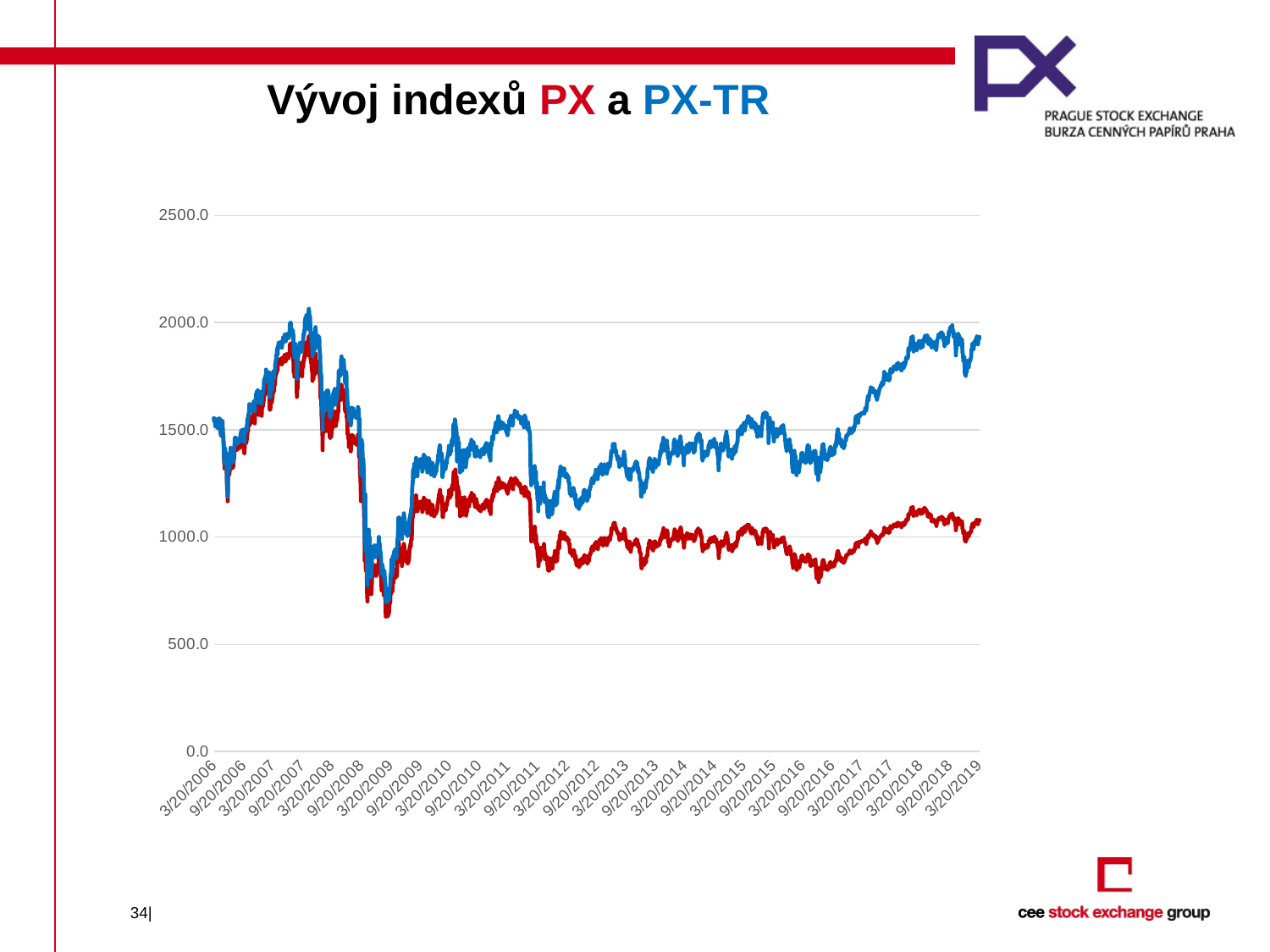
Is the value of PX at 9/20/2016 greater or less than 1000? less How many data series (lines) are plotted on the chart? 2 Is the value of PX-TR at 3/20/2019 greater or less than 1500? greater At 3/20/2019, which index has the higher value, PX or PX-TR? PX-TR What is the title of the slide containing the chart? Vývoj indexů PX a PX-TR Does the PX-TR line rise or fall between 3/20/2016 and 3/20/2018? rise What kind of chart is shown on the slide? line chart Does the PX line rise or fall between 9/20/2007 and 3/20/2009? fall Is the value of PX at 3/20/2006 greater or less than 1000? greater Which colour is used for the PX index line? red